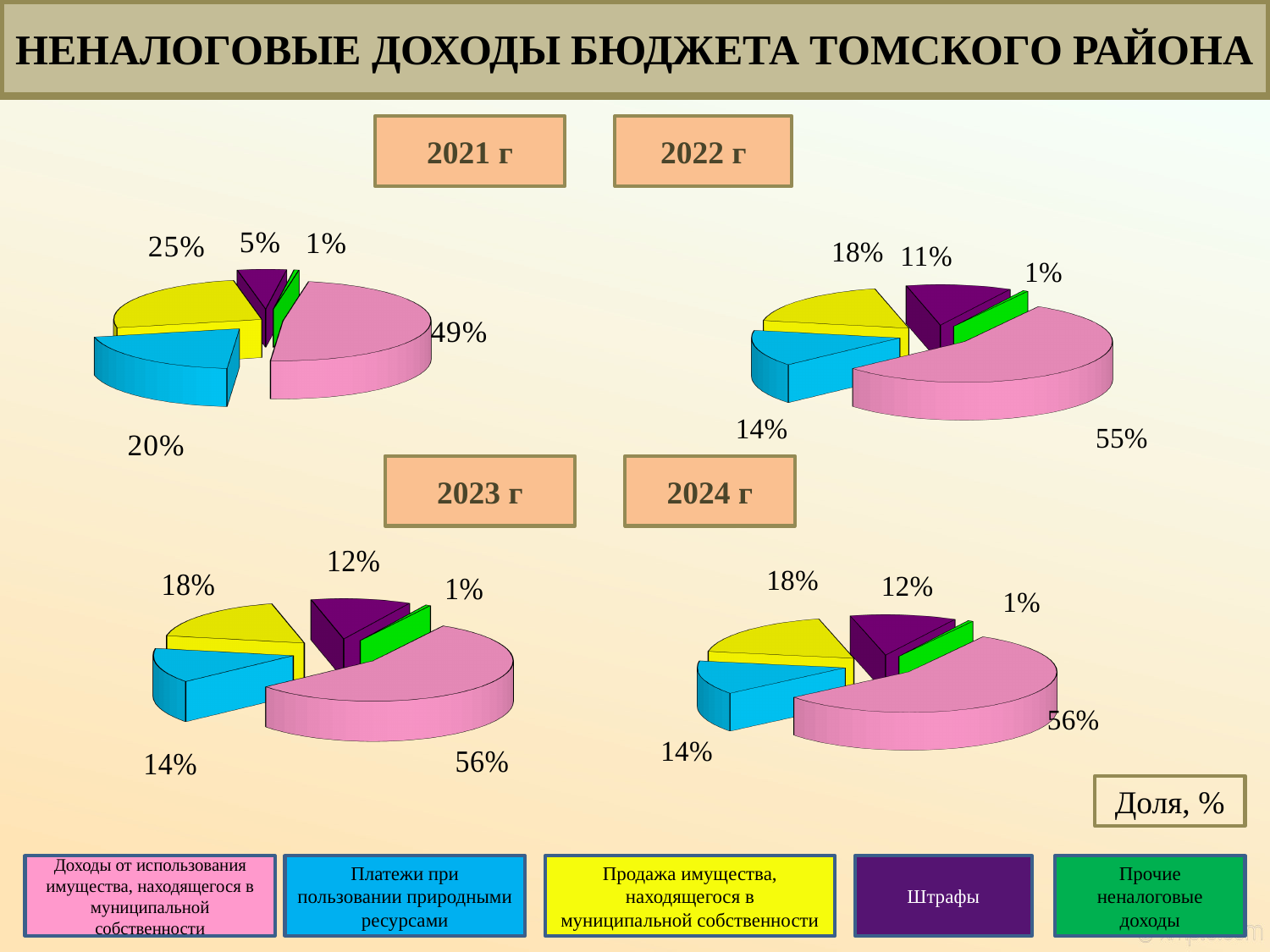
Which colour represents fines (Штрафы) in the legend? Purple In the 2024 pie chart, what share is shown for sale of municipally owned property (yellow slice)? 18% In the 2021 pie chart, which category has the largest share? Доходы от использования имущества, находящегося в муниципальной собственности In the 2022 pie chart, which category has the smallest share? Прочие неналоговые доходы How many categories does the legend at the bottom of the slide list? 5 In the 2023 pie chart, what share is shown for payments for the use of natural resources (blue slice)? 14% In the 2021 pie chart, what is the difference between the yellow slice (25%) and the blue slice (20%)? 5% In the 2021 pie chart, what share is shown for income from the use of municipally owned property (pink slice)? 49% In the 2022 pie chart, what share is shown for fines (Штрафы, purple slice)? 11% In the 2022 pie chart, which is larger: the share for sale of municipal property (yellow) or the share for fines (purple)? Sale of municipal property (yellow), 18% How many slices does the 2023 pie chart have? 5 What type of chart is used for each year on this slide? Pie chart